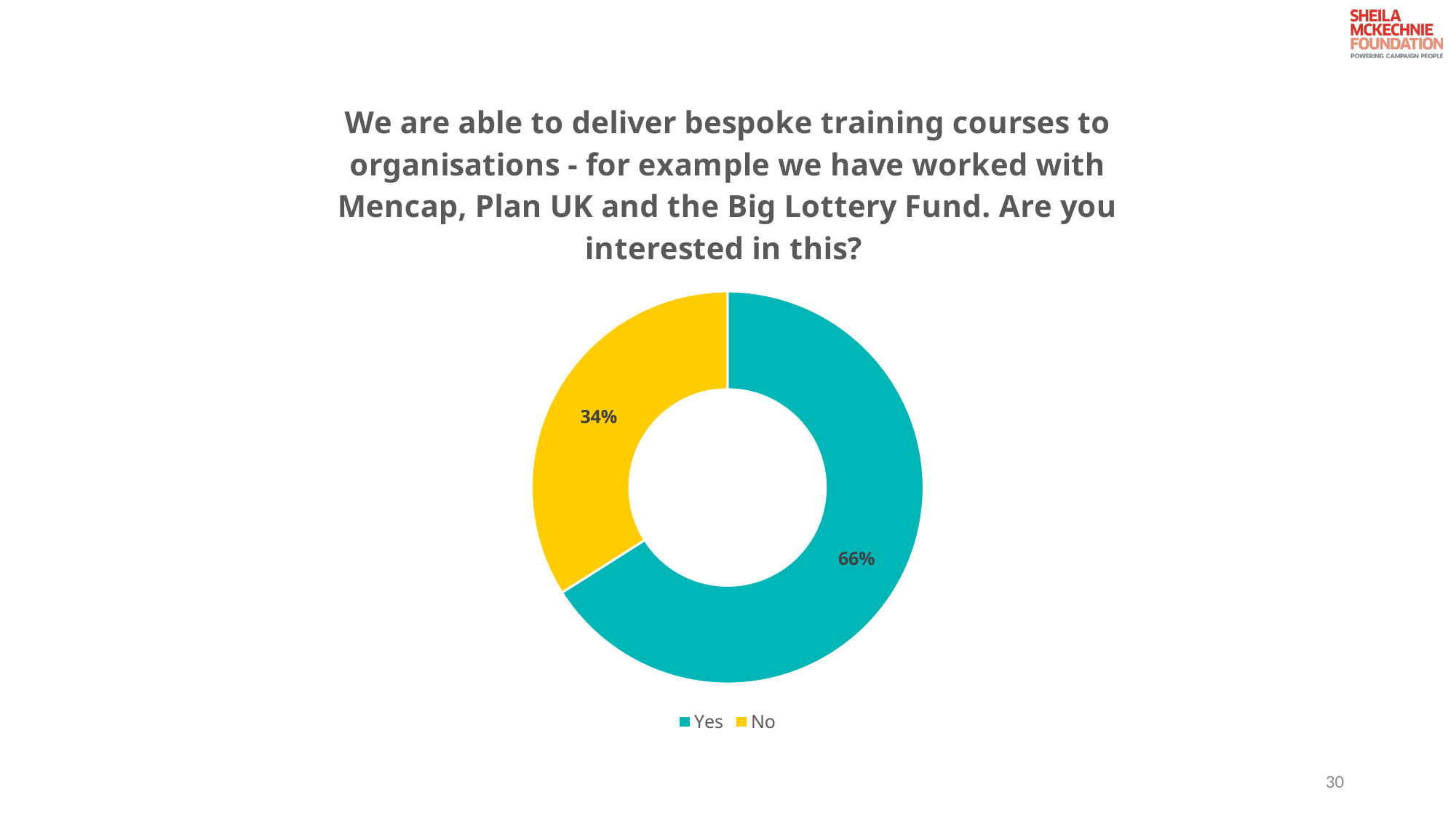
Which is larger, the share for Yes or the share for No? Yes What share of the chart does the Yes slice represent? 66% What colour is the Yes slice? Teal What colour is the No slice? Yellow What percentage of respondents answered Yes? 66% Which response has the largest share of the chart? Yes What is the difference in percentage points between the Yes and No shares? 32 How many categories are shown in the chart? 2 What percentage of respondents answered No? 34% What kind of chart is shown on the slide? Doughnut (pie) chart How many entries does the legend list? 2 Which response has the smallest share of the chart? No